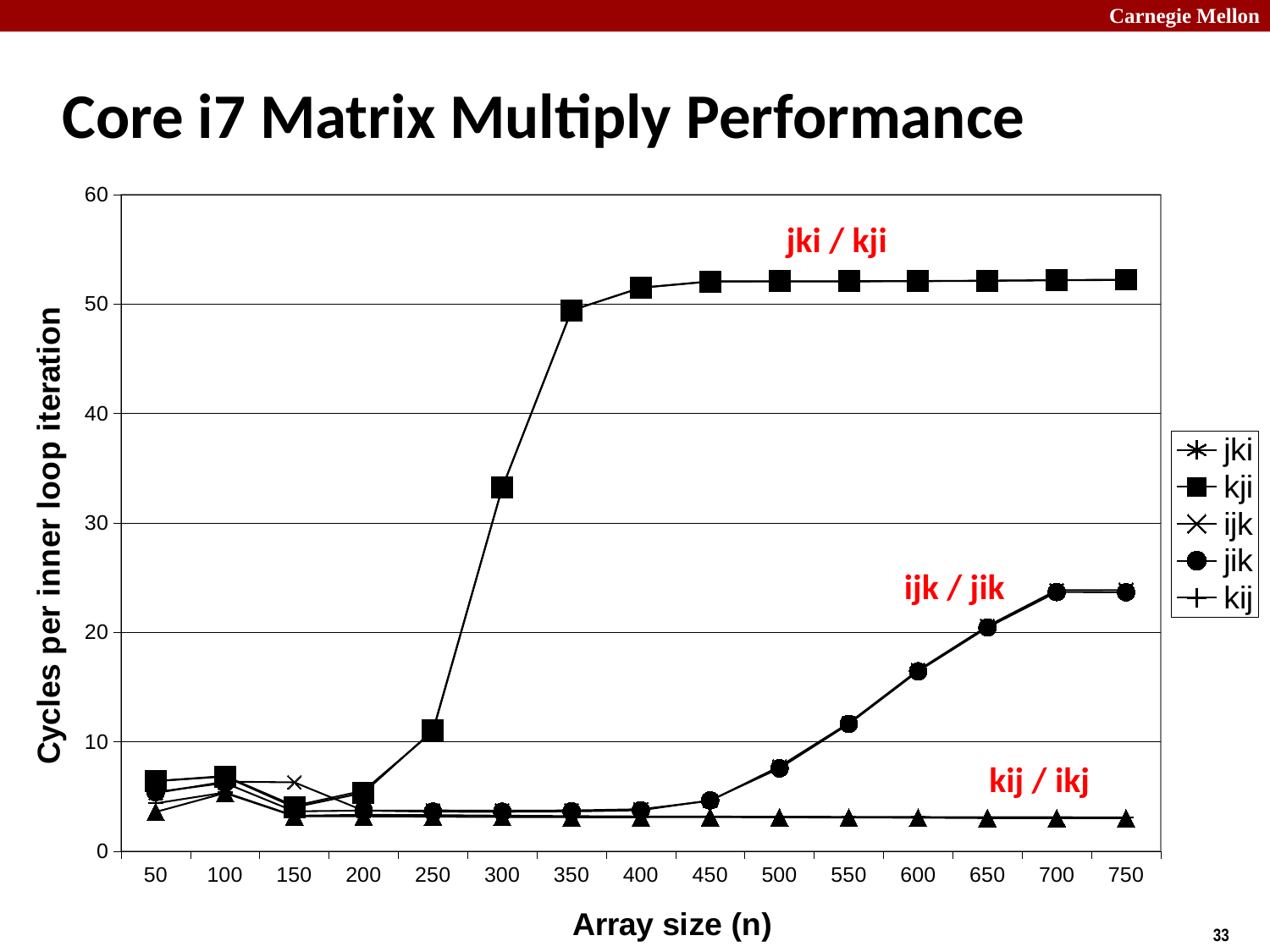
Is the value for kij at array size 750 greater or less than 10? less At array size 600, which series has the larger value, jik or kij? jik Is the value for kji at array size 300 greater or less than 30? greater What is the title of the y axis? Cycles per inner loop iteration Does the kji series rise or fall between array sizes 200 and 400? rise How many array size values are shown along the x axis? 15 Is the value for kji at array size 750 greater or less than 50? greater What kind of chart is shown on the slide? line chart How many series does the legend list? 5 At array size 750, which series has the larger value, kji or jik? kji